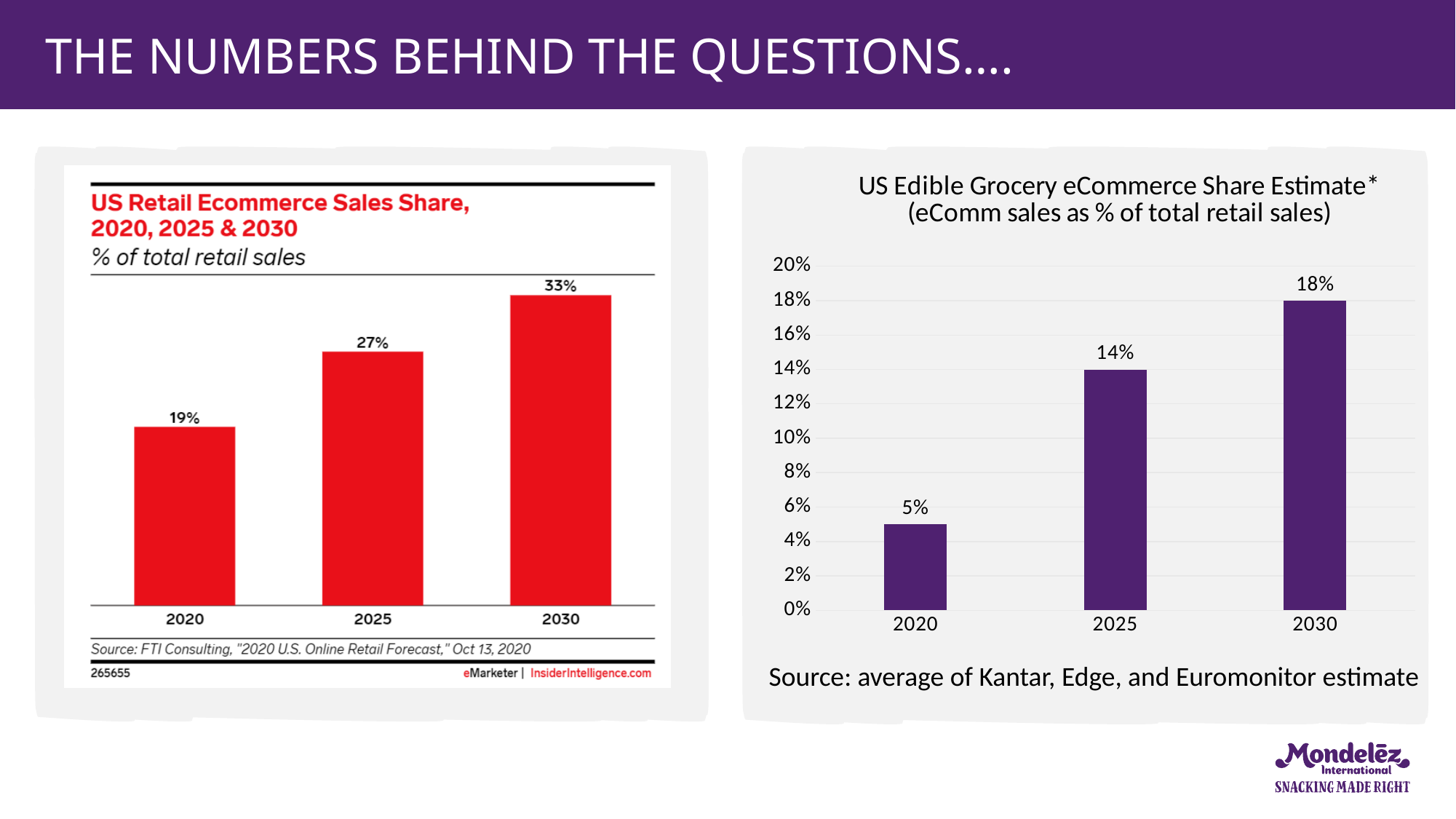
In the 'US Retail Ecommerce Sales Share' chart on the left, what is the value for 2025? 27% In the 'US Retail Ecommerce Sales Share' chart on the left, do the values rise or fall from 2020 to 2030? rise In the 'US Edible Grocery eCommerce Share Estimate' chart on the right, what is the value for 2020? 5% In the 'US Retail Ecommerce Sales Share' chart on the left, how many years are shown? 3 In the 'US Retail Ecommerce Sales Share' chart on the left, which year has the highest value? 2030 In the 'US Edible Grocery eCommerce Share Estimate' chart on the right, what is the difference between the 2025 and 2020 values? 9% In the 'US Edible Grocery eCommerce Share Estimate' chart on the right, which year has the lowest value? 2020 What kind of chart is the 'US Edible Grocery eCommerce Share Estimate' chart on the right? bar chart Which is larger: the 2030 value in the left chart or the 2030 value in the right chart? the left chart (33%) In the 'US Edible Grocery eCommerce Share Estimate' chart on the right, is the value for 2025 greater or less than 10%? greater In the 'US Edible Grocery eCommerce Share Estimate' chart on the right, what is the value for 2030? 18% In the 'US Retail Ecommerce Sales Share' chart on the left, what is the difference between the 2030 and 2020 values? 14%